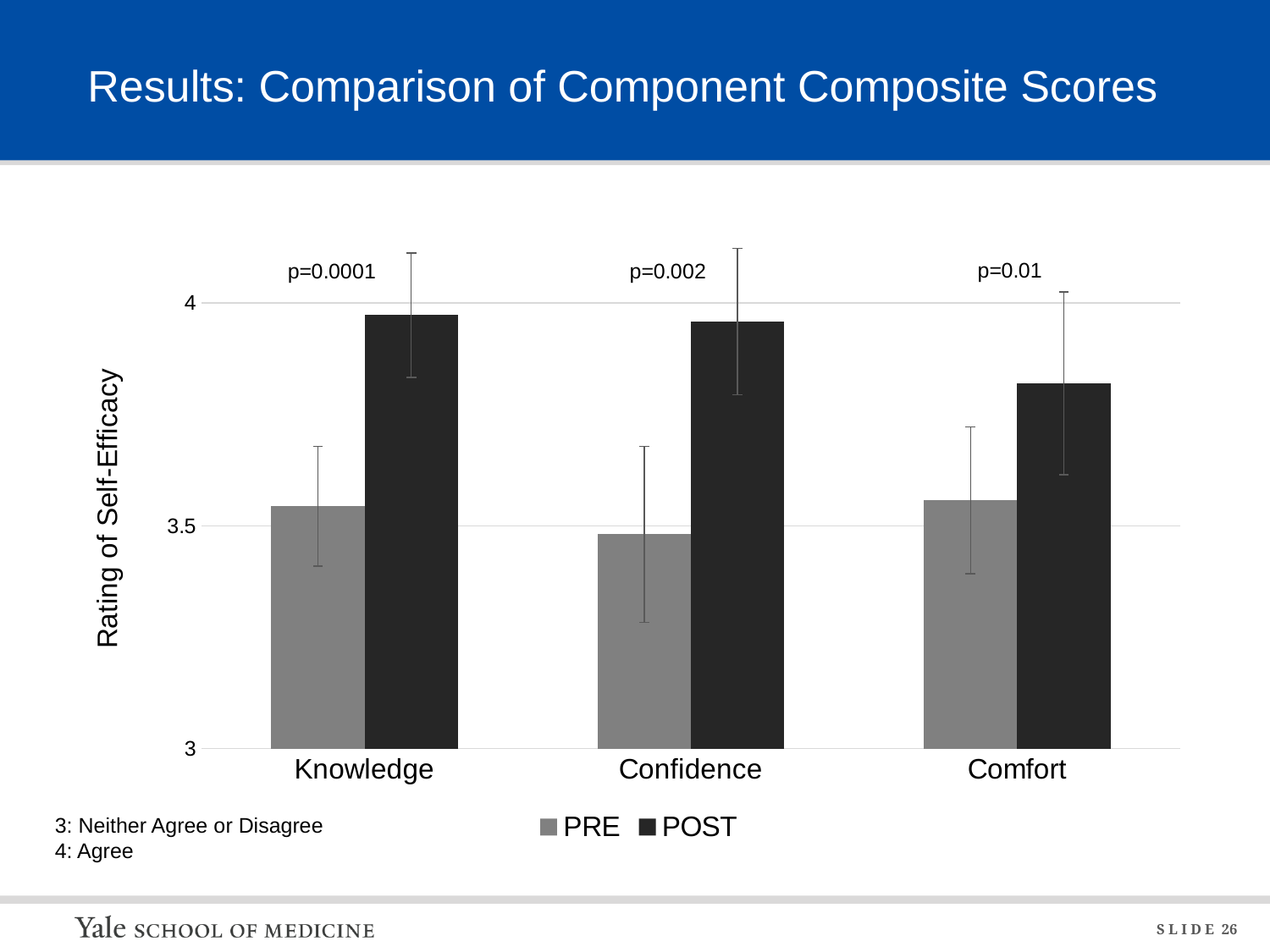
What kind of chart is shown on the slide? bar chart Is the POST value for Comfort greater or less than 3.5? greater Which series has the larger value for Knowledge, PRE or POST? POST How many categories are shown on the x axis of the chart? 3 Which series has the larger value for Comfort, PRE or POST? POST Which series has the larger value for Confidence, PRE or POST? POST Is the POST value for Comfort greater or less than 4? less What p-value is printed above the Knowledge bars? p=0.0001 What is the title of the y axis? Rating of Self-Efficacy How many series does the chart's legend list? 2 Is the POST value for Knowledge greater or less than 3.5? greater Among the POST bars, which category has the lowest value? Comfort